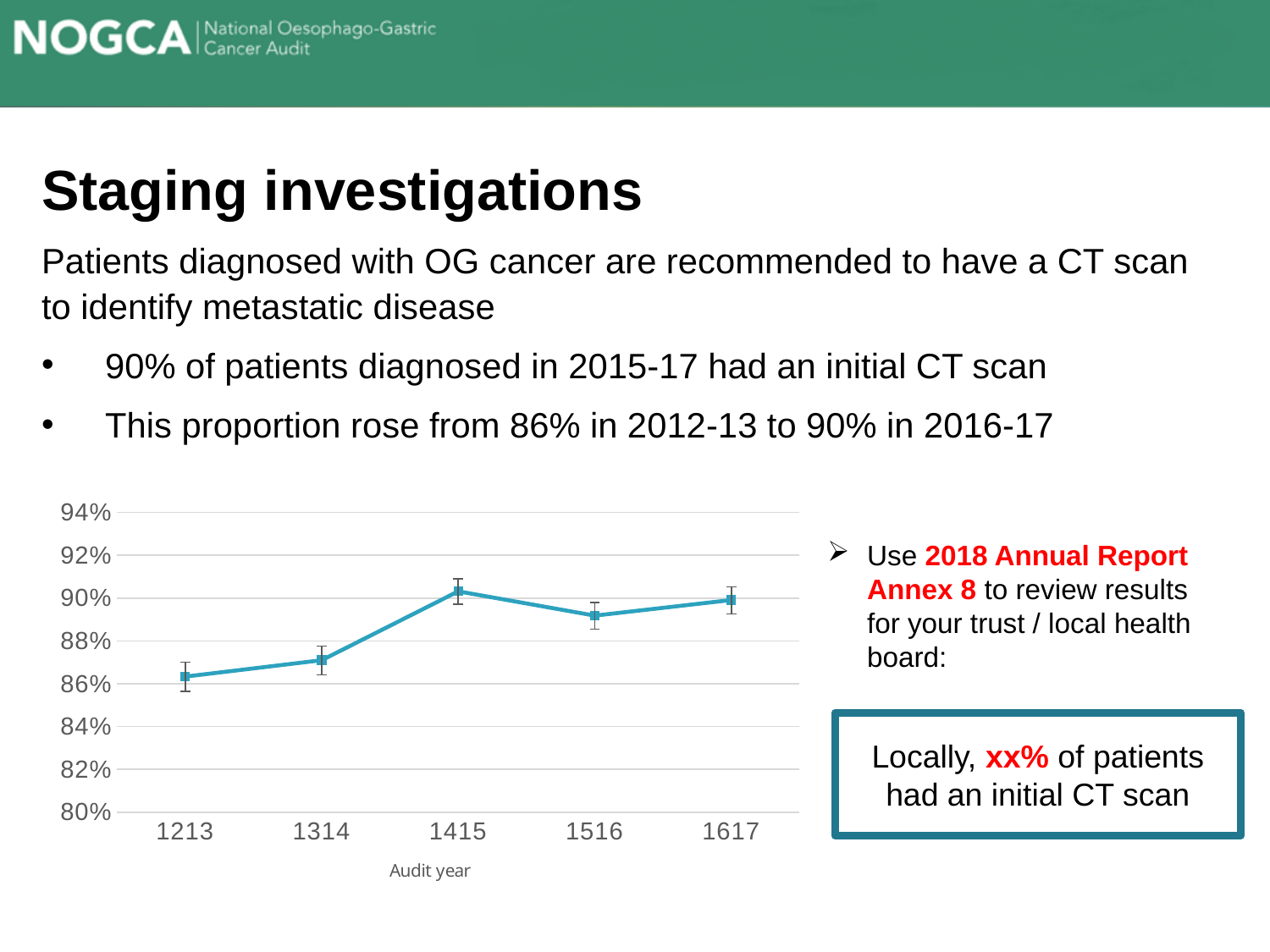
Which is larger, the value for 1213 or the value for 1415? 1415 Is the value for 1415 greater or less than 88%? greater How many audit years are plotted on the chart? 5 Which audit year has the lowest value on the chart? 1213 Is the value for 1314 greater or less than 88%? less What kind of chart is shown on the slide? line chart Is the value for 1213 greater or less than 88%? less What is the title of the x axis of the chart? Audit year Which is larger, the value for 1314 or the value for 1617? 1617 Overall, do the values rise or fall from 1213 to 1617? rise